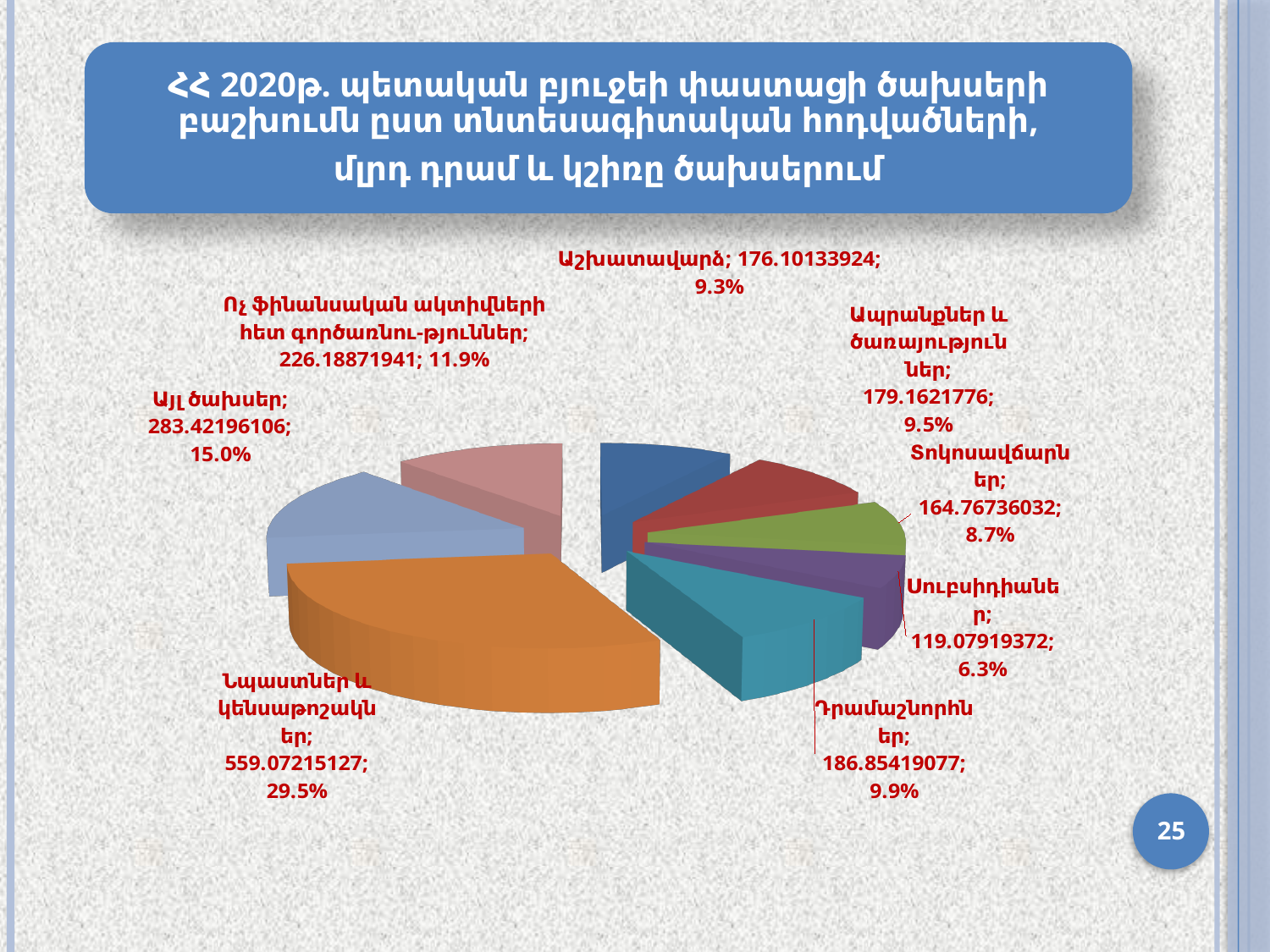
What year does the chart title refer to? 2020 What percentage is shown for Այլ ծախսեր? 15.0% What share of the pie does Սուբսիդիաներ represent? 6.3% What is the value shown for Դրամաշնորհներ? 186.85419077 What is the value shown for Նպաստներ և կենսաթոշակներ? 559.07215127 How many slices does the pie chart have? 8 Which category has the largest slice of the pie? Նպաստներ և կենսաթոշակներ What is the difference in percentage points between the share of Այլ ծախսեր and the share of Ոչ ֆինանսական ակտիվների հետ գործառնություններ? 3.1 What kind of chart is shown on the slide? pie chart Which category has the smallest slice of the pie? Սուբսիդիաներ What percentage is shown for Ապրանքներ և ծառայություններ? 9.5% Which is larger, the value for Աշխատավարձ or the value for Տոկոսավճարներ? Աշխատավարձ